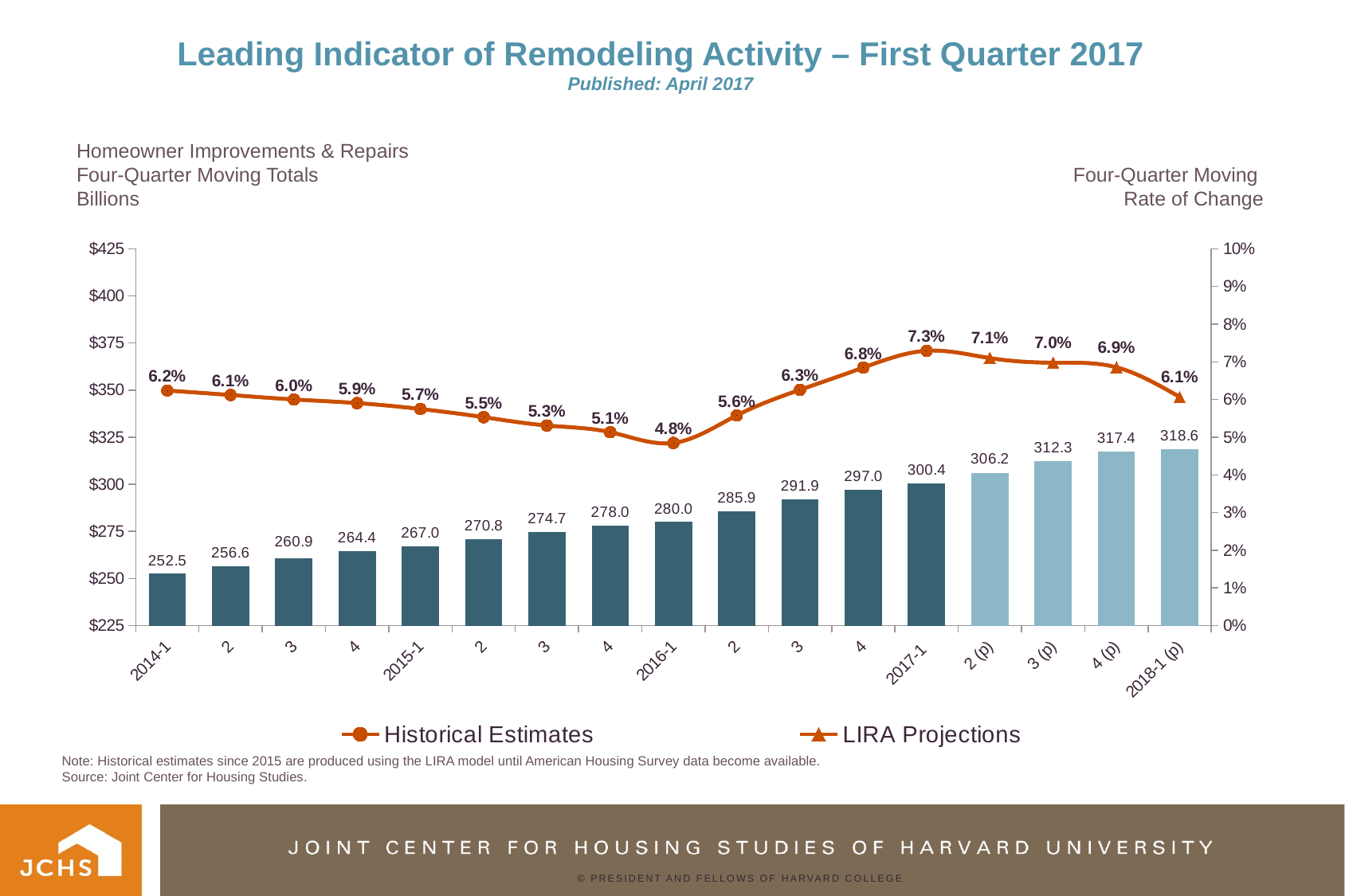
How many quarters are shown along the x axis? 17 What is the difference between the four-quarter moving total for 2018-1 (p) and for 2014-1? 66.1 What kind of chart is shown on the slide? Combination bar and line chart What are the two series named in the legend? Historical Estimates and LIRA Projections Which quarter has the highest four-quarter moving rate of change? 2017-1 Which has the higher rate of change, 2015-1 or 2016-1? 2015-1 Do the four-quarter moving totals (bars) rise or fall from 2014-1 to 2018-1 (p)? Rise Which quarter has the lowest four-quarter moving rate of change? 2016-1 How many series does the legend list? 2 What is the four-quarter moving total shown for the projected quarter 2 (p) of 2017? 306.2 What is the four-quarter moving total (in billions) shown for 2016-1? 280.0 What is the four-quarter moving rate of change shown for 2017-1? 7.3%